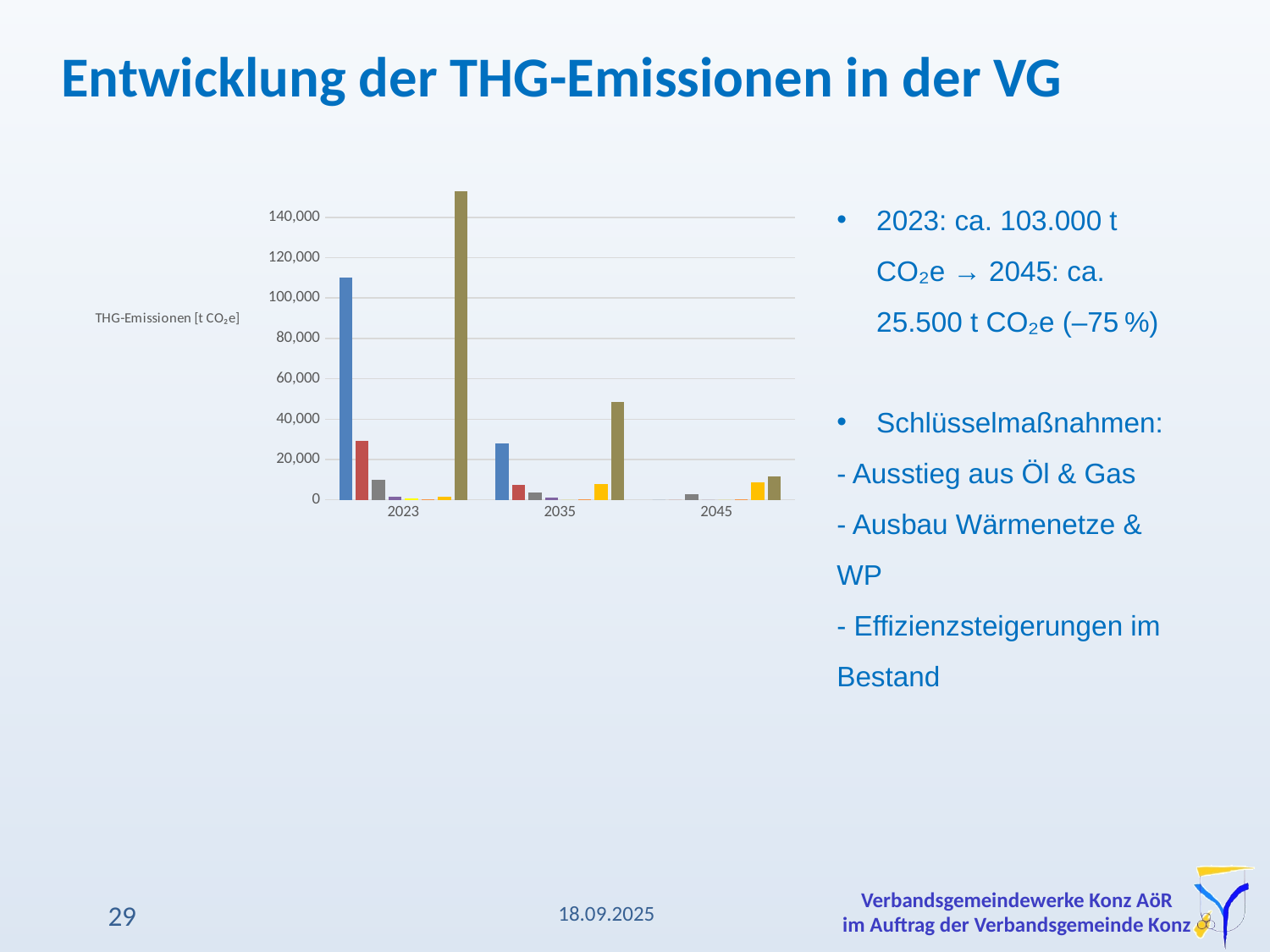
Is the value of the blue bar for 2035 greater or less than 20,000? greater Which is larger: the blue bar for 2023 or the blue bar for 2035? the blue bar for 2023 Which year category contains the tallest bar in the chart? 2023 Is the value of the red bar for 2023 greater or less than 40,000? less Is the value of the olive bar for 2035 greater or less than 60,000? less What is the label of the vertical axis of the chart? THG-Emissionen [t CO₂e] How many year categories are shown on the x axis of the chart? 3 What is the title of the slide containing the chart? Entwicklung der THG-Emissionen in der VG Do the tallest bars in each year group rise or fall from 2023 to 2045? fall What kind of chart is shown on the slide? bar chart